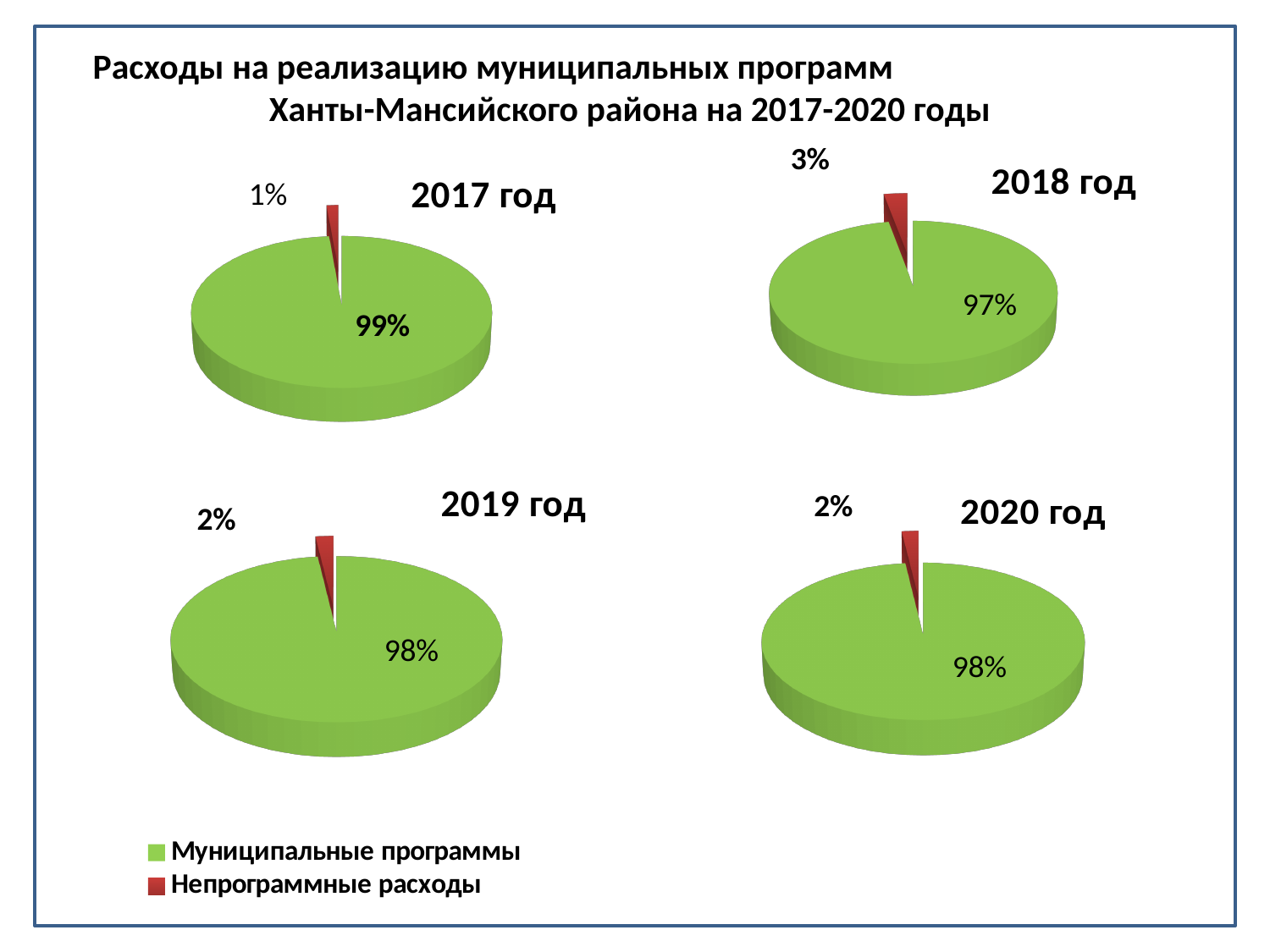
In the 2017 год pie chart, which slice is the smallest? Непрограммные расходы How many series does the legend list? 2 In the 2019 год pie chart, what share is shown for Муниципальные программы? 98% In the 2017 год pie chart, what share is shown for Непрограммные расходы? 1% In the 2017 год pie chart, what share is shown for Муниципальные программы? 99% In the 2020 год pie chart, what share is shown for Непрограммные расходы? 2% Which is larger: the Непрограммные расходы share in the 2018 год chart or in the 2017 год chart? 2018 год In the 2018 год pie chart, which slice is the largest? Муниципальные программы In the 2018 год pie chart, what share is shown for Муниципальные программы? 97% In the 2018 год pie chart, what is the difference between the shares of Муниципальные программы and Непрограммные расходы? 94% What type of chart is used for each year on the slide? Pie chart In the 2018 год pie chart, what share is shown for Непрограммные расходы? 3%